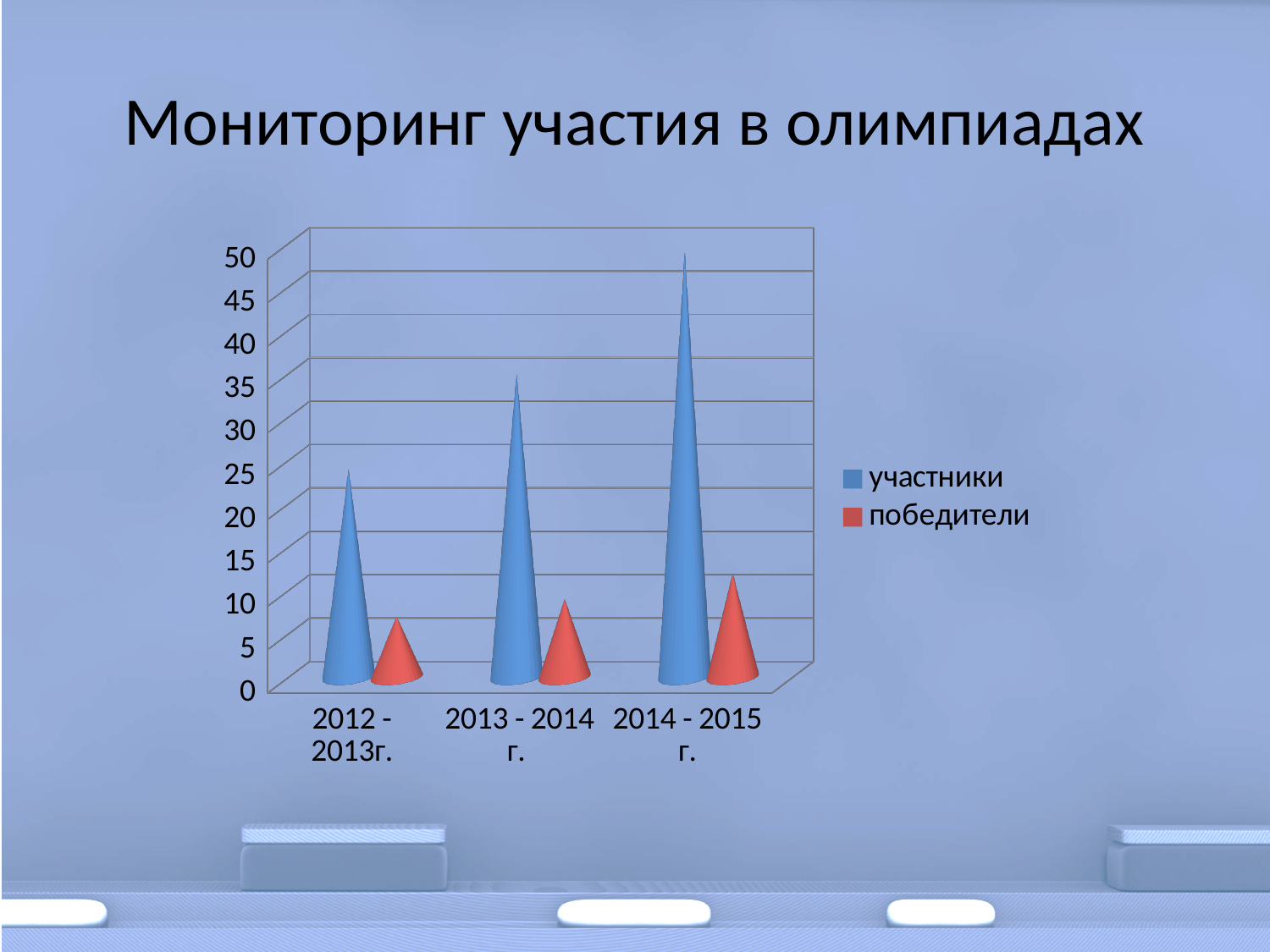
Is the value for участники in 2012 - 2013г. greater or less than 30? less Do the values for участники rise or fall from 2012 - 2013г. to 2014 - 2015 г.? rise What is the title of the chart? Мониторинг участия в олимпиадах In which year is the value for участники highest? 2014 - 2015 г. Which series is shown in red? победители How many categories (school years) are shown on the x axis? 3 What kind of chart is shown on the slide? bar chart Is the value for участники in 2014 - 2015 г. greater or less than 40? greater Is the value for победители in 2012 - 2013г. greater or less than 10? less In which year is the value for победители highest? 2014 - 2015 г. In which year is the value for участники lowest? 2012 - 2013г. How many series does the legend list? 2